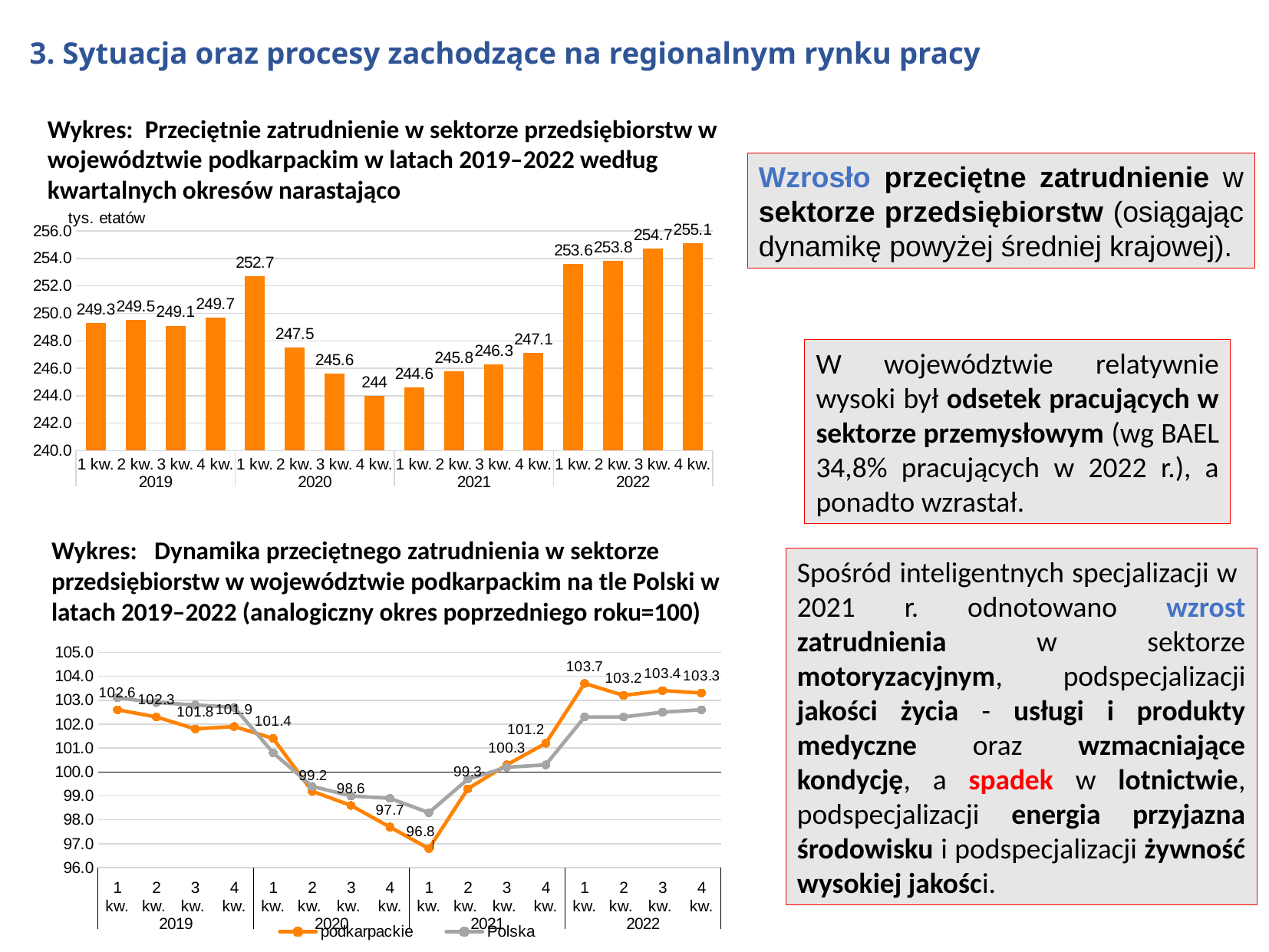
In the top chart, which quarter has the lowest value? 4 kw. 2020 How many bars are plotted in the top chart? 16 In the bottom chart, in which quarter does the podkarpackie series reach its highest value? 1 kw. 2022 In the top chart, what is the value for 4 kw. 2022? 255.1 In the bottom chart, what is the value for podkarpackie in 1 kw. 2021? 96.8 In the top chart, what is the difference between the values for 4 kw. 2022 and 1 kw. 2019? 5.8 In the top chart, what is the value for 1 kw. 2020? 252.7 In the top chart, which is larger: the value for 1 kw. 2020 or for 1 kw. 2021? 1 kw. 2020 What unit is shown on the vertical axis of the top chart? tys. etatów How many series does the legend of the bottom chart (Dynamika przeciętnego zatrudnienia) list? 2 In the top chart, which quarter has the highest value? 4 kw. 2022 What kind of chart is the top chart (Przeciętnie zatrudnienie w sektorze przedsiębiorstw)? bar chart